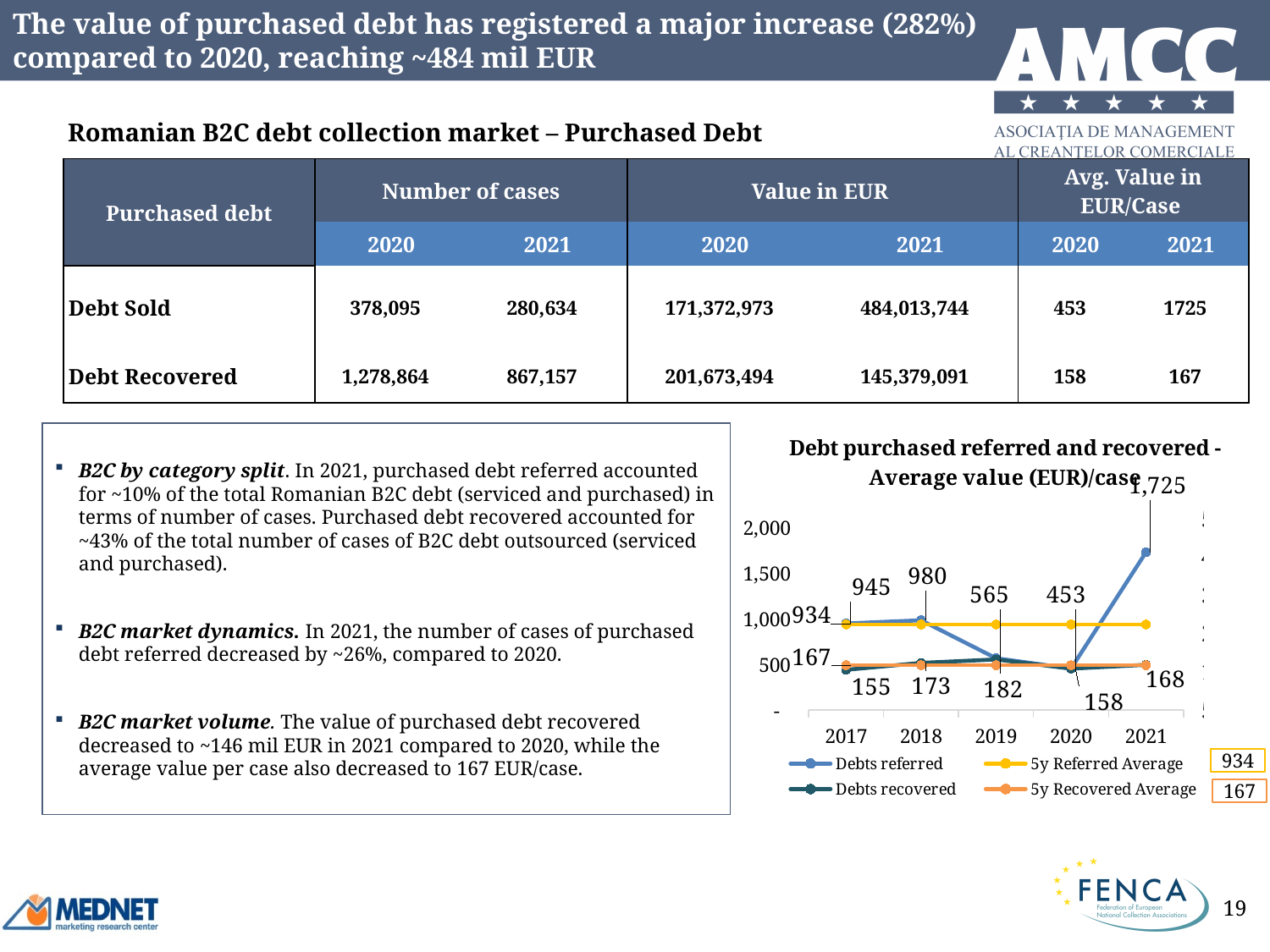
How many series does the chart legend list? 4 What is the value for Debts referred in 2021? 1,725 How many years are shown on the x axis of the chart? 5 What is the 5y Referred Average shown on the chart? 934 In which year is the value for Debts referred lowest? 2020 What is the value for Debts recovered in 2019? 182 What is the value for Debts referred in 2018? 980 In which year is the value for Debts referred highest? 2021 What is the difference between Debts referred in 2021 and Debts referred in 2020? 1,272 What type of chart is shown on the slide? line chart Which is larger: Debts recovered in 2019 or Debts recovered in 2020? Debts recovered in 2019 Does the Debts referred series rise or fall from 2018 to 2020? fall